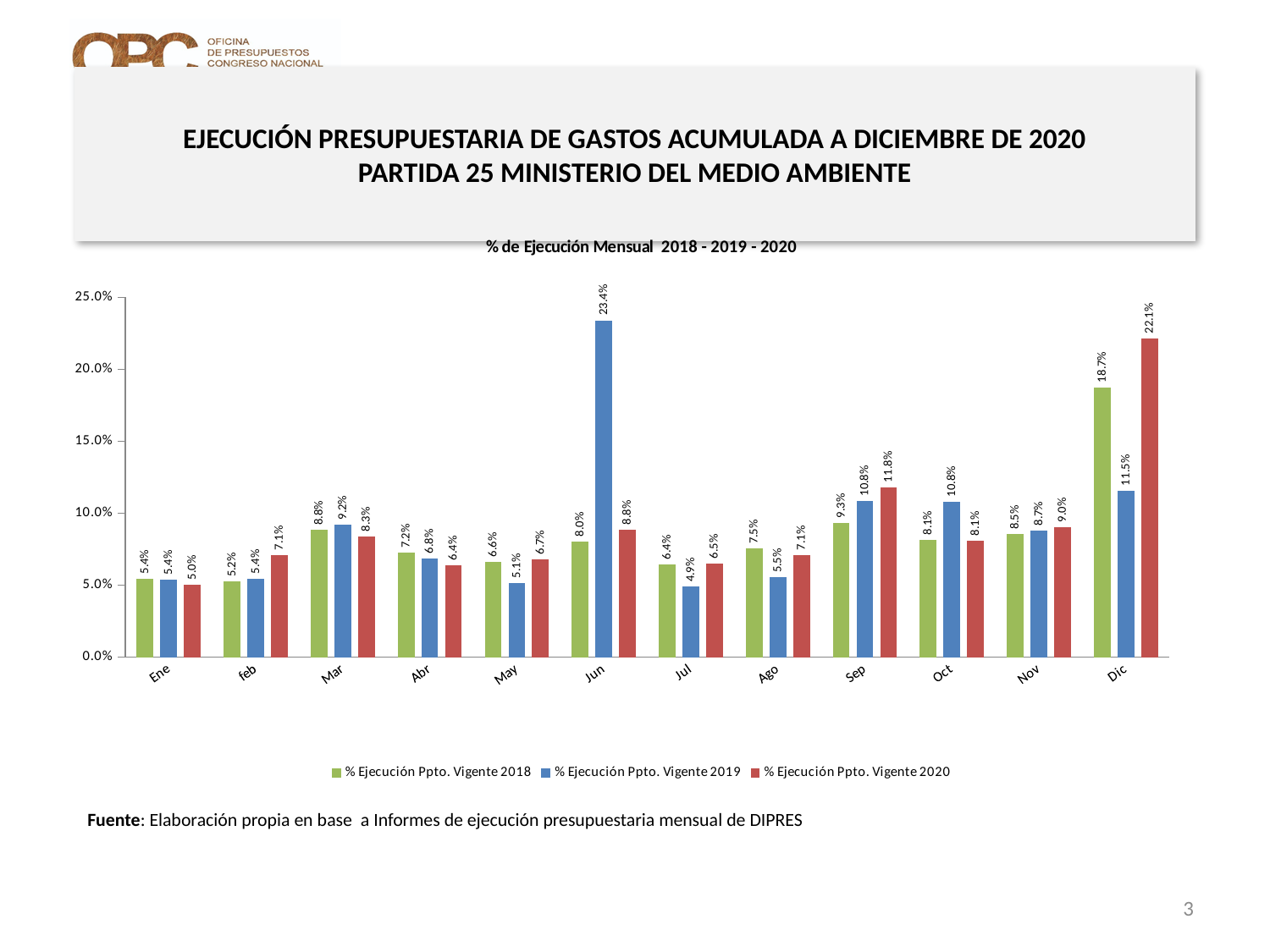
How many months are shown on the x axis? 12 Which is larger for Oct: the % Ejecución Ppto. Vigente 2019 value or the % Ejecución Ppto. Vigente 2018 value? % Ejecución Ppto. Vigente 2019 Which month has the highest value in the % Ejecución Ppto. Vigente 2018 series? Dic What is the value for Sep in the % Ejecución Ppto. Vigente 2018 series? 9.3% What is the title of the chart? % de Ejecución Mensual 2018 - 2019 - 2020 What is the value for Dic in the % Ejecución Ppto. Vigente 2020 series? 22.1% Is the value for Jun in the % Ejecución Ppto. Vigente 2019 series greater or less than 20.0%? greater What kind of chart is shown? Bar chart What is the difference between the 2020 and 2018 values for Dic? 3.4% Which month has the lowest value in the % Ejecución Ppto. Vigente 2019 series? Jul How many series does the legend list? 3 What is the value for Jun in the % Ejecución Ppto. Vigente 2019 series? 23.4%